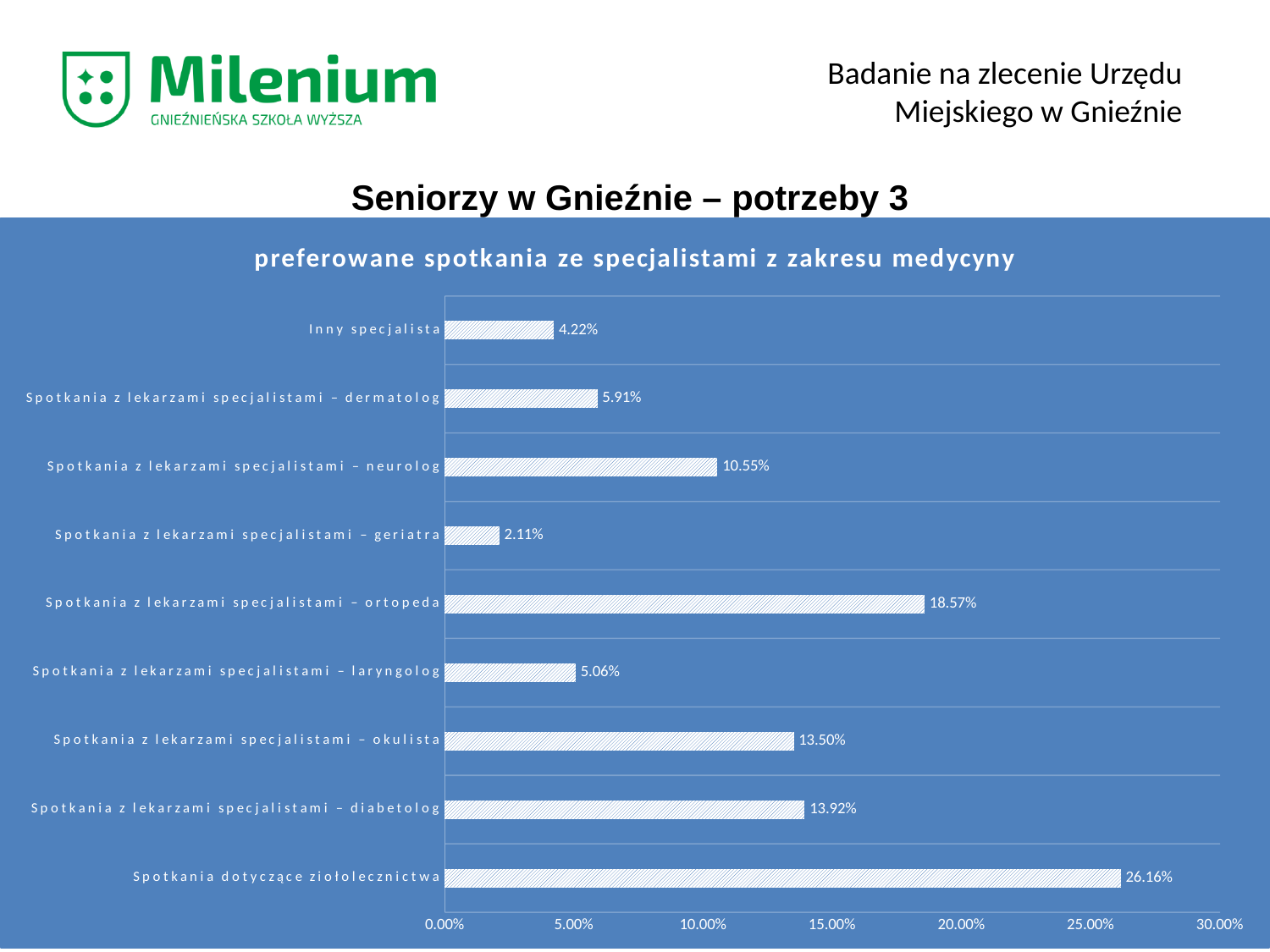
What is the value for "Inny specjalista"? 4.22% What is the difference between the values for "Spotkania z lekarzami specjalistami – diabetolog" and "Spotkania z lekarzami specjalistami – okulista"? 0.42% Is the value for "Spotkania z lekarzami specjalistami – ortopeda" greater or less than 15.00%? greater Which category has the highest value? Spotkania dotyczące ziołolecznictwa Which category has the lowest value? Spotkania z lekarzami specjalistami – geriatra How many categories are shown in the chart? 9 What kind of chart is shown on the slide? bar chart What is the value for "Spotkania z lekarzami specjalistami – ortopeda"? 18.57% What is the value for "Spotkania dotyczące ziołolecznictwa"? 26.16% What is the title of the chart? preferowane spotkania ze specjalistami z zakresu medycyny What is the maximum value shown on the x axis? 30.00% Which is larger: the value for "Spotkania z lekarzami specjalistami – neurolog" or for "Spotkania z lekarzami specjalistami – dermatolog"? Spotkania z lekarzami specjalistami – neurolog